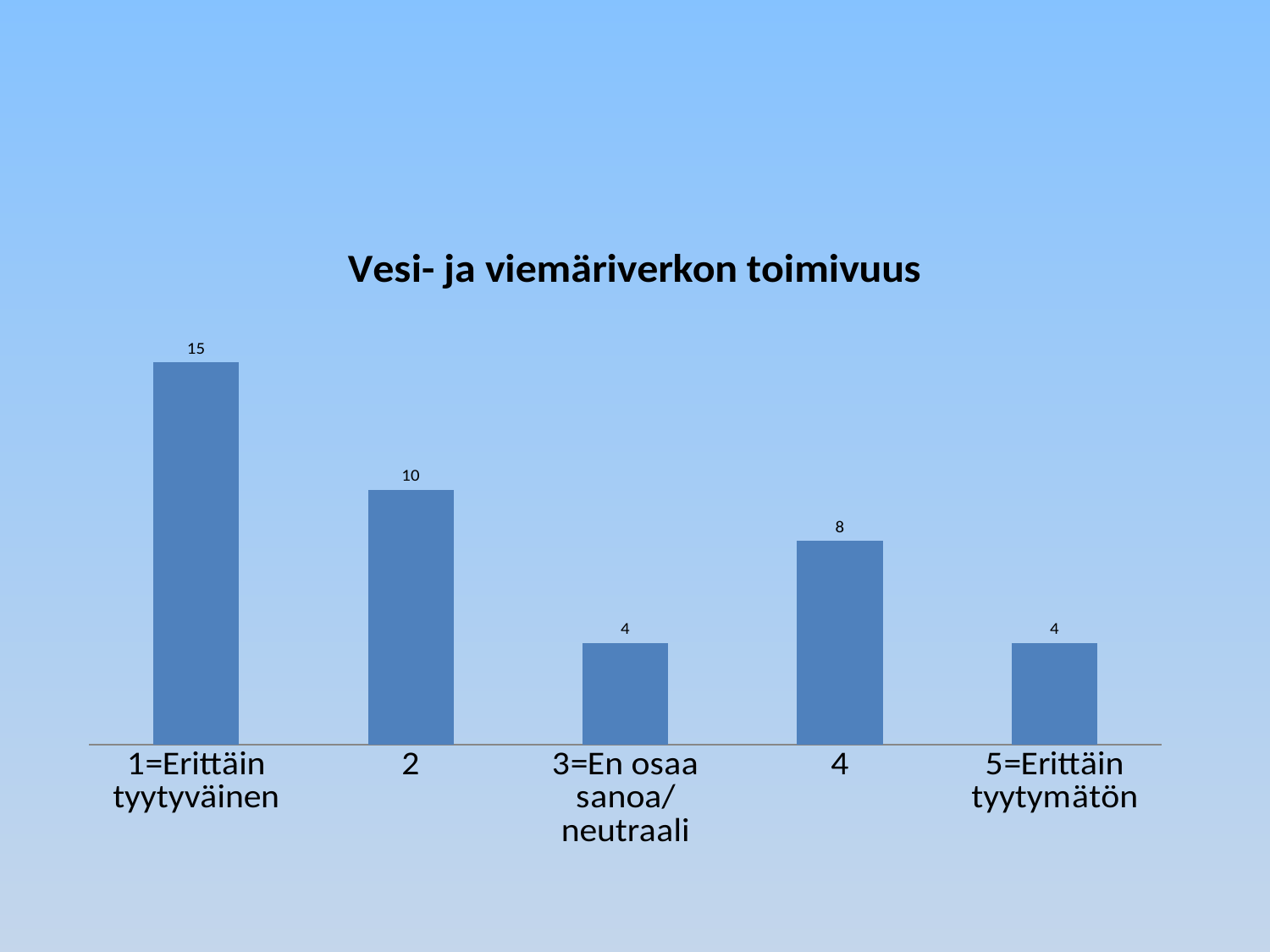
What is the difference between the values for category "4" and "5=Erittäin tyytymätön"? 4 How many categories are shown on the x axis? 5 What is the value for "3=En osaa sanoa/ neutraali"? 4 Which category has the highest value? 1=Erittäin tyytyväinen Which is larger, the value for category "2" or the value for category "4"? 2 What is the difference between the values for "1=Erittäin tyytyväinen" and "2"? 5 What is the value for "1=Erittäin tyytyväinen"? 15 What is the value for "5=Erittäin tyytymätön"? 4 What is the value for category "4"? 8 What is the title of the chart? Vesi- ja viemäriverkon toimivuus What kind of chart is shown on the slide? Bar chart What is the value for category "2"? 10